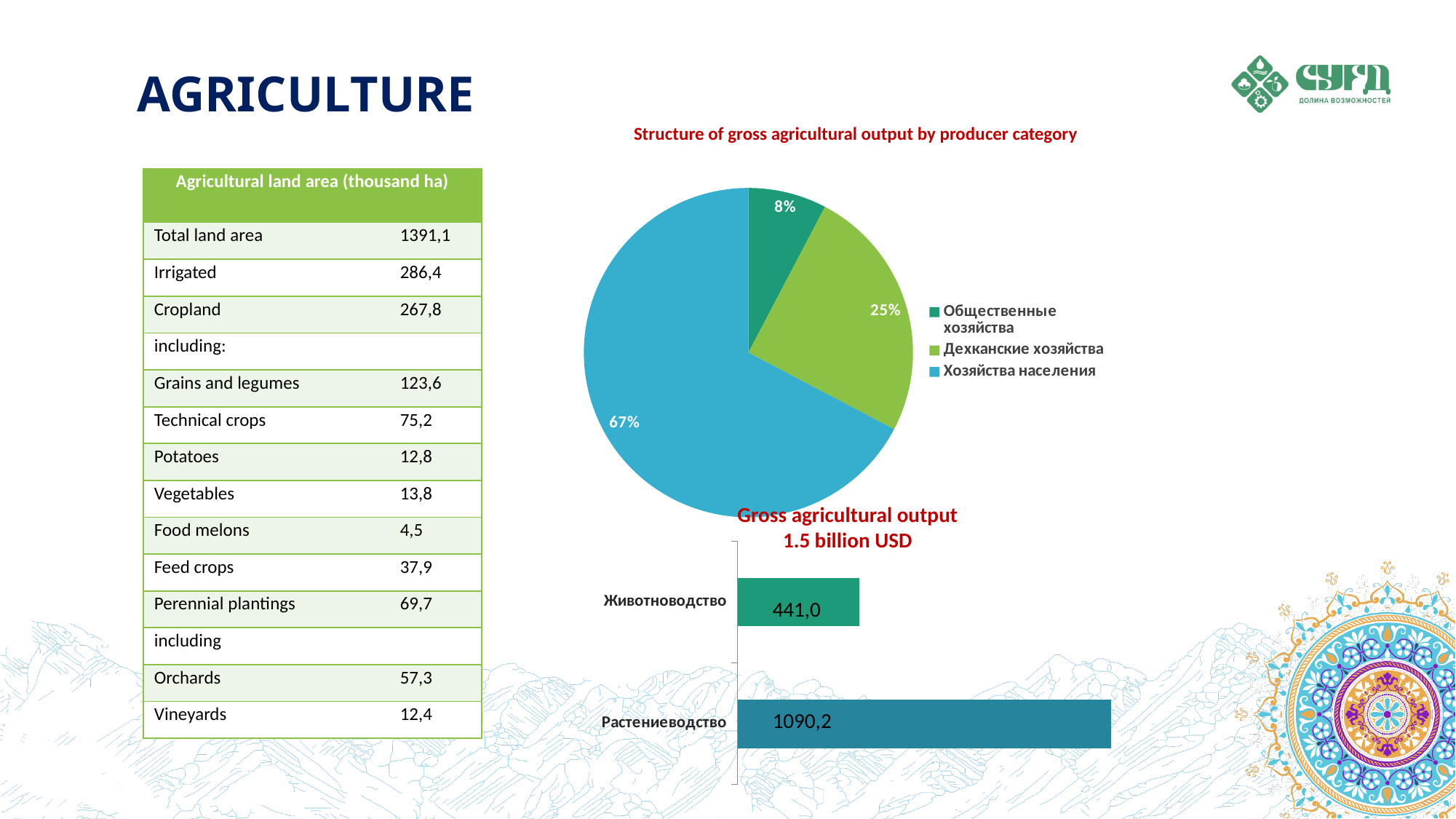
What kind of chart is the 'Structure of gross agricultural output by producer category' chart? Pie chart In the 'Gross agricultural output 1.5 billion USD' chart, what is the value for Растениеводство? 1090,2 In the 'Gross agricultural output 1.5 billion USD' chart, which category has the larger value, Животноводство or Растениеводство? Растениеводство In the pie chart 'Structure of gross agricultural output by producer category', what share is labelled for Хозяйства населения? 67% In the pie chart 'Structure of gross agricultural output by producer category', what share is labelled for Общественные хозяйства? 8% In the pie chart 'Structure of gross agricultural output by producer category', how many categories does the legend list? 3 In the pie chart 'Structure of gross agricultural output by producer category', what share is labelled for Дехканские хозяйства? 25% In the pie chart 'Structure of gross agricultural output by producer category', which category has the largest slice? Хозяйства населения In the pie chart 'Structure of gross agricultural output by producer category', which category has the smallest slice? Общественные хозяйства In the pie chart 'Structure of gross agricultural output by producer category', what is the difference in percentage points between Хозяйства населения and Дехканские хозяйства? 42 What kind of chart is the 'Gross agricultural output 1.5 billion USD' chart? Bar chart In the 'Gross agricultural output 1.5 billion USD' chart, what is the value for Животноводство? 441,0